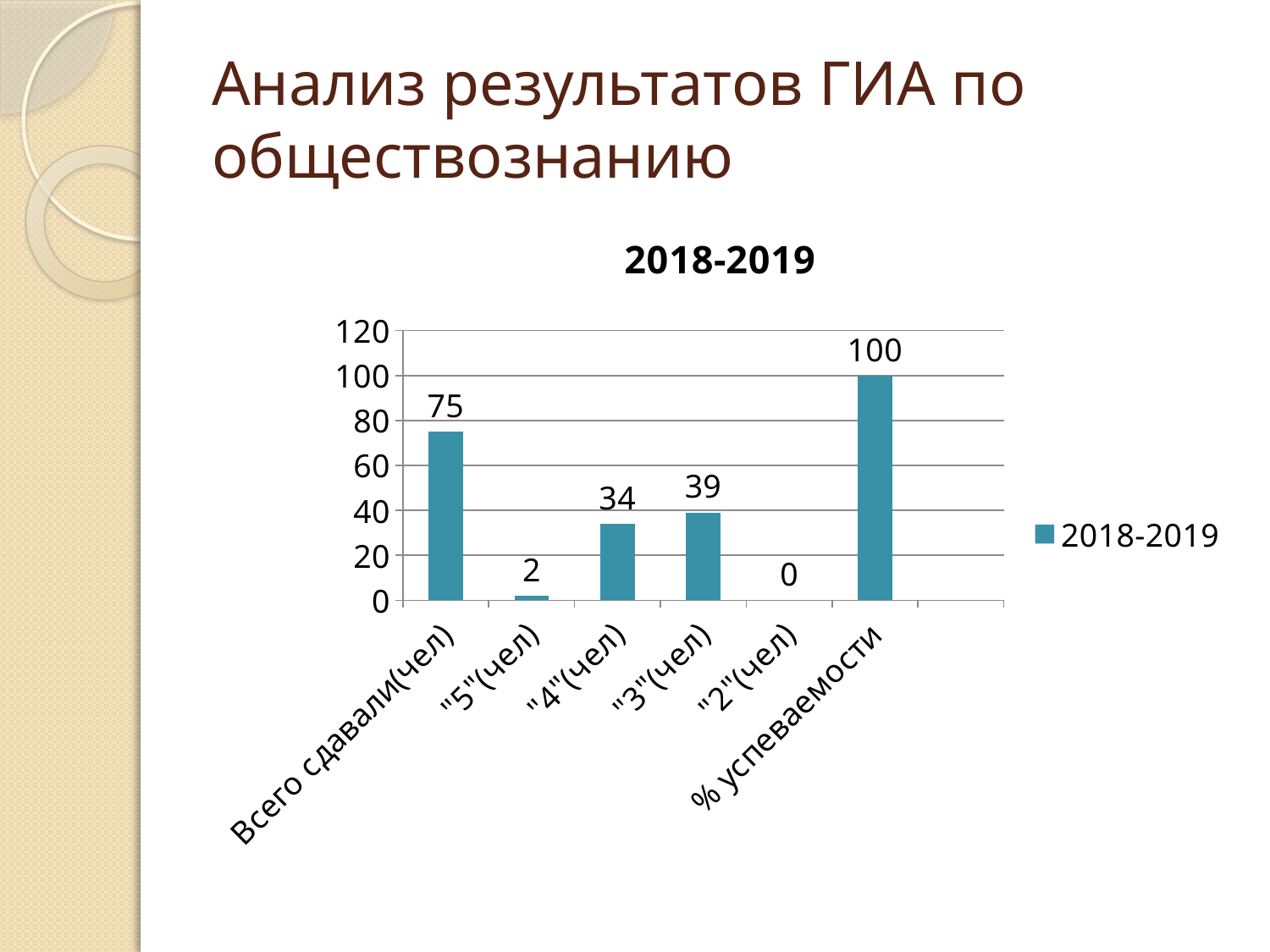
How many categories are shown on the x axis? 6 What is the value for ""4"(чел)"? 34 How many series does the legend list? 1 Which category has the highest value? % успеваемости What kind of chart is shown? bar chart What is the value for "% успеваемости"? 100 Which category has the lowest value? "2"(чел) What is the value for ""5"(чел)"? 2 What is the value for "Всего сдавали(чел)"? 75 What is the value for ""3"(чел)"? 39 What is the difference between the values for ""3"(чел)" and ""4"(чел)"? 5 Which is larger, the value for ""3"(чел)" or ""4"(чел)"? "3"(чел)